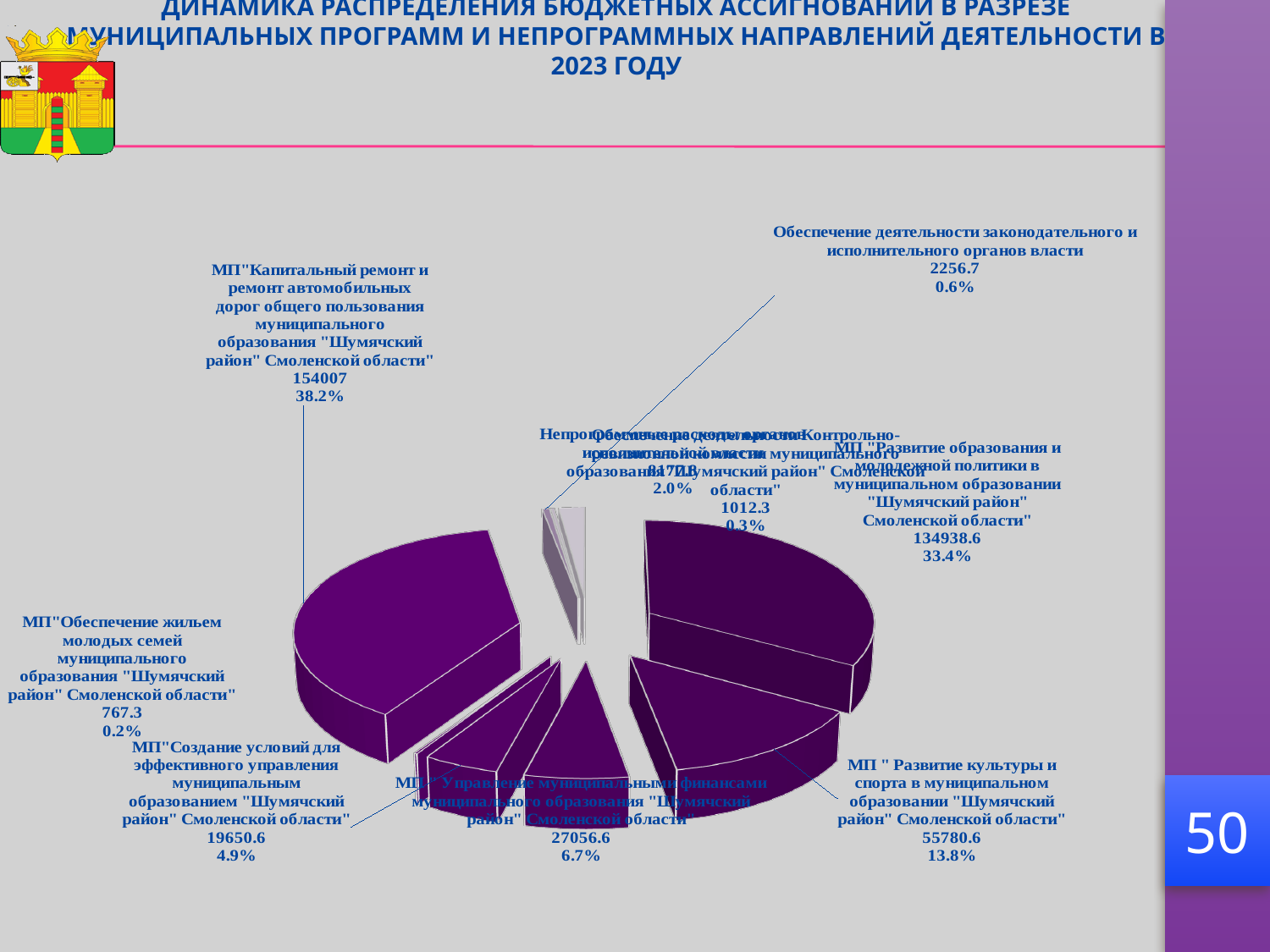
What is the value for МП "Создание условий для эффективного управления муниципальным образованием"? 19650.6 Which category has the smallest share of the pie? МП "Обеспечение жильем молодых семей" What kind of chart is shown on the slide? pie chart What is the difference between the values for МП "Капитальный ремонт и ремонт автомобильных дорог" and МП "Развитие образования и молодежной политики"? 19068.4 What is the value for МП "Капитальный ремонт и ремонт автомобильных дорог общего пользования"? 154007 What is the value for МП "Развитие культуры и спорта"? 55780.6 What share of the pie does МП "Управление муниципальными финансами" have? 6.7% Which is larger: the value for МП "Развитие культуры и спорта" or МП "Управление муниципальными финансами"? МП "Развитие культуры и спорта" What is the value for Обеспечение деятельности законодательного и исполнительного органов власти? 2256.7 Which category has the largest share of the pie? МП "Капитальный ремонт и ремонт автомобильных дорог общего пользования" What share of the pie does МП "Обеспечение жильем молодых семей" have? 0.2% What share of the pie does МП "Развитие образования и молодежной политики" have? 33.4%